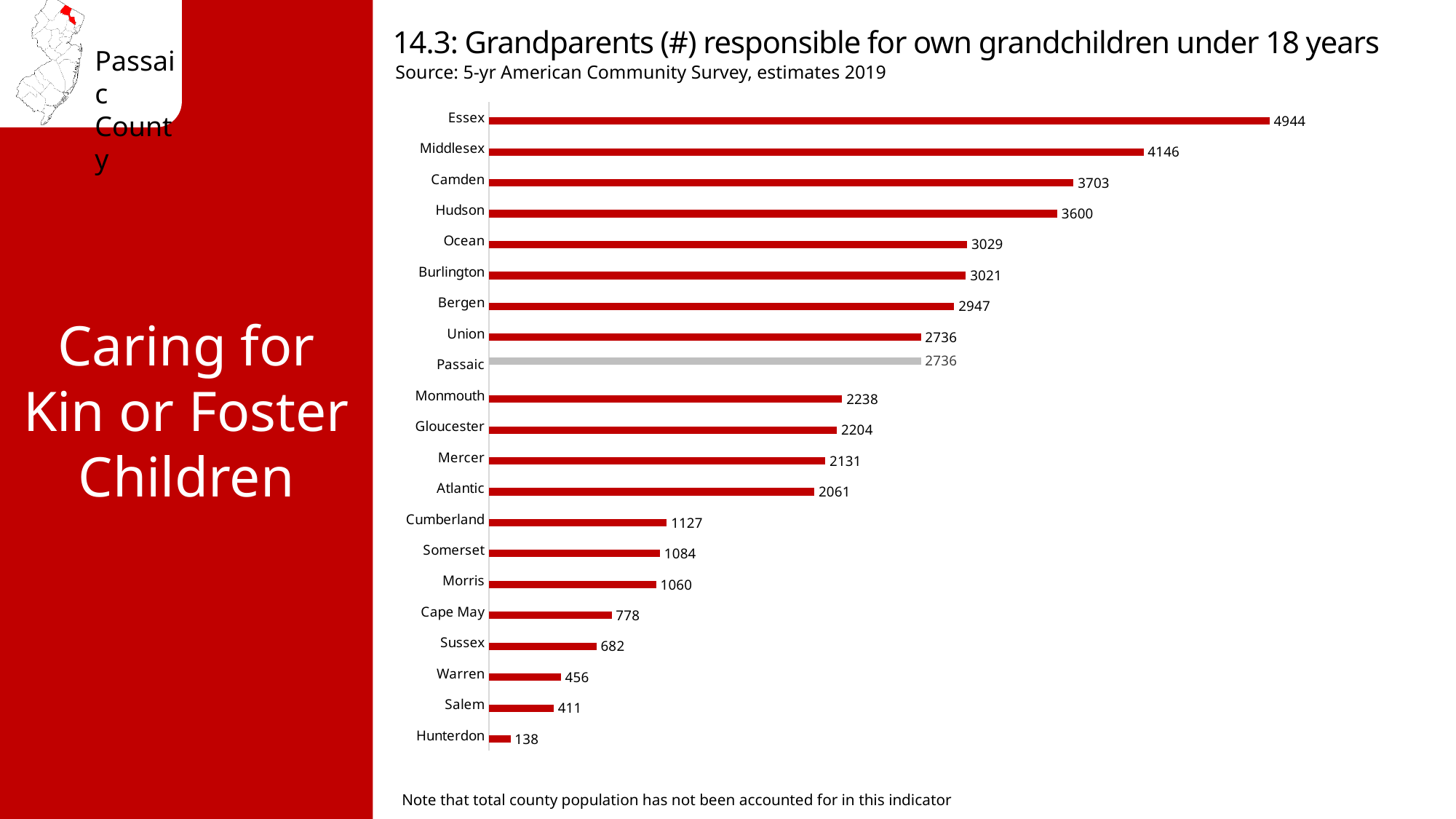
What kind of chart is this? Bar chart Which is larger, the value for Camden or the value for Ocean? Camden What is the value for Cape May? 778 What is the difference between the values for Essex and Middlesex? 798 Which county has the highest value? Essex Which county has the lowest value? Hunterdon What is the difference between the values for Passaic and Monmouth? 498 What is the value for Passaic? 2736 Which county's bar is shown in grey rather than red? Passaic What is the value for Hudson? 3600 Which is larger, the value for Sussex or the value for Warren? Sussex How many counties are shown in the chart? 21